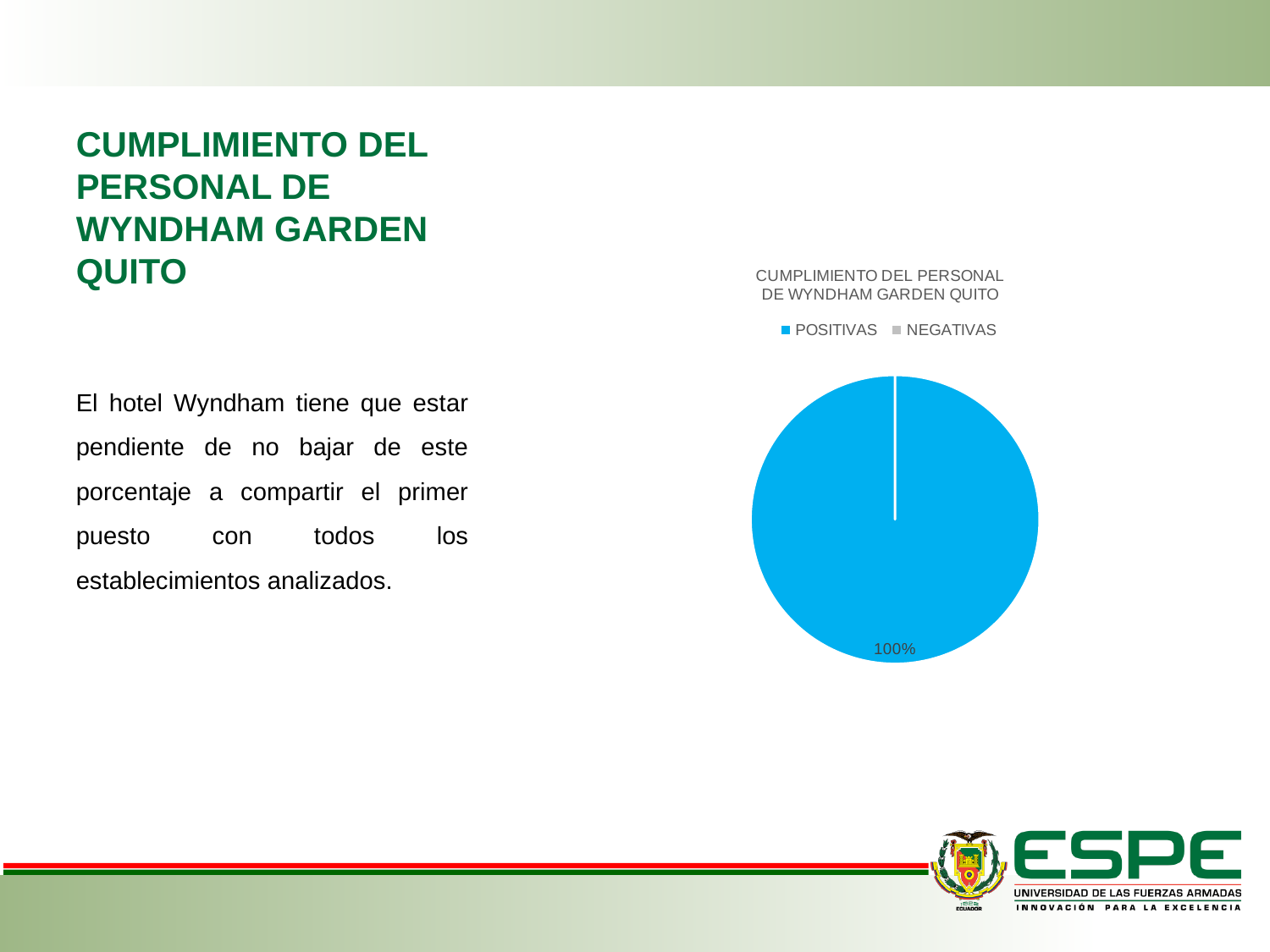
What are the two categories listed in the chart legend? POSITIVAS and NEGATIVAS What kind of chart is shown on the slide? pie chart What colour represents POSITIVAS in the chart? blue What is the title of the chart? CUMPLIMIENTO DEL PERSONAL DE WYNDHAM GARDEN QUITO What value is printed on the pie chart? 100% Which category has the largest share of the pie? POSITIVAS Is the share for POSITIVAS greater or less than 50%? greater What share of the pie does POSITIVAS take? 100% Which category has the smaller share of the pie, POSITIVAS or NEGATIVAS? NEGATIVAS How many entries does the chart legend list? 2